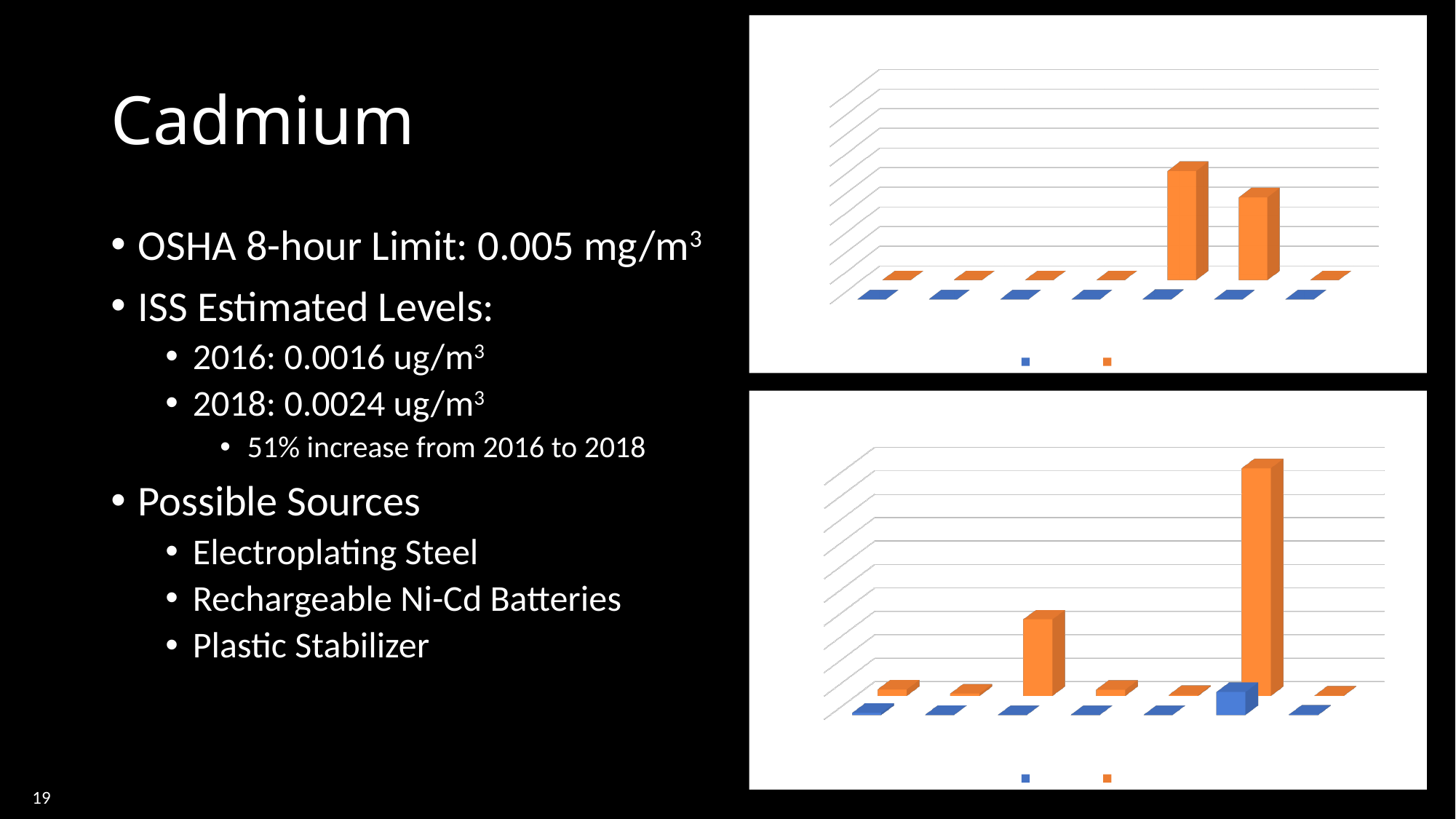
In the top chart, how many series does the legend list? 2 In the bottom chart, which series colour has the tallest bar? orange In the bottom chart, is the orange bar at the third position taller or shorter than the orange bar at the sixth position? shorter In the top chart, is the orange bar at the fifth position taller or shorter than the orange bar at the sixth position? taller In the top chart, how many categories are plotted along the x axis? 7 What kind of chart is the top chart on the slide? bar chart In the bottom chart, how many series does the legend list? 2 What kind of chart is the bottom chart on the slide? bar chart In the top chart, which category position from the left has the tallest bar? fifth In the bottom chart, how many categories are plotted along the x axis? 7 In the bottom chart, which category position from the left has the tallest bar? sixth In the top chart, what colours are the two series? blue and orange